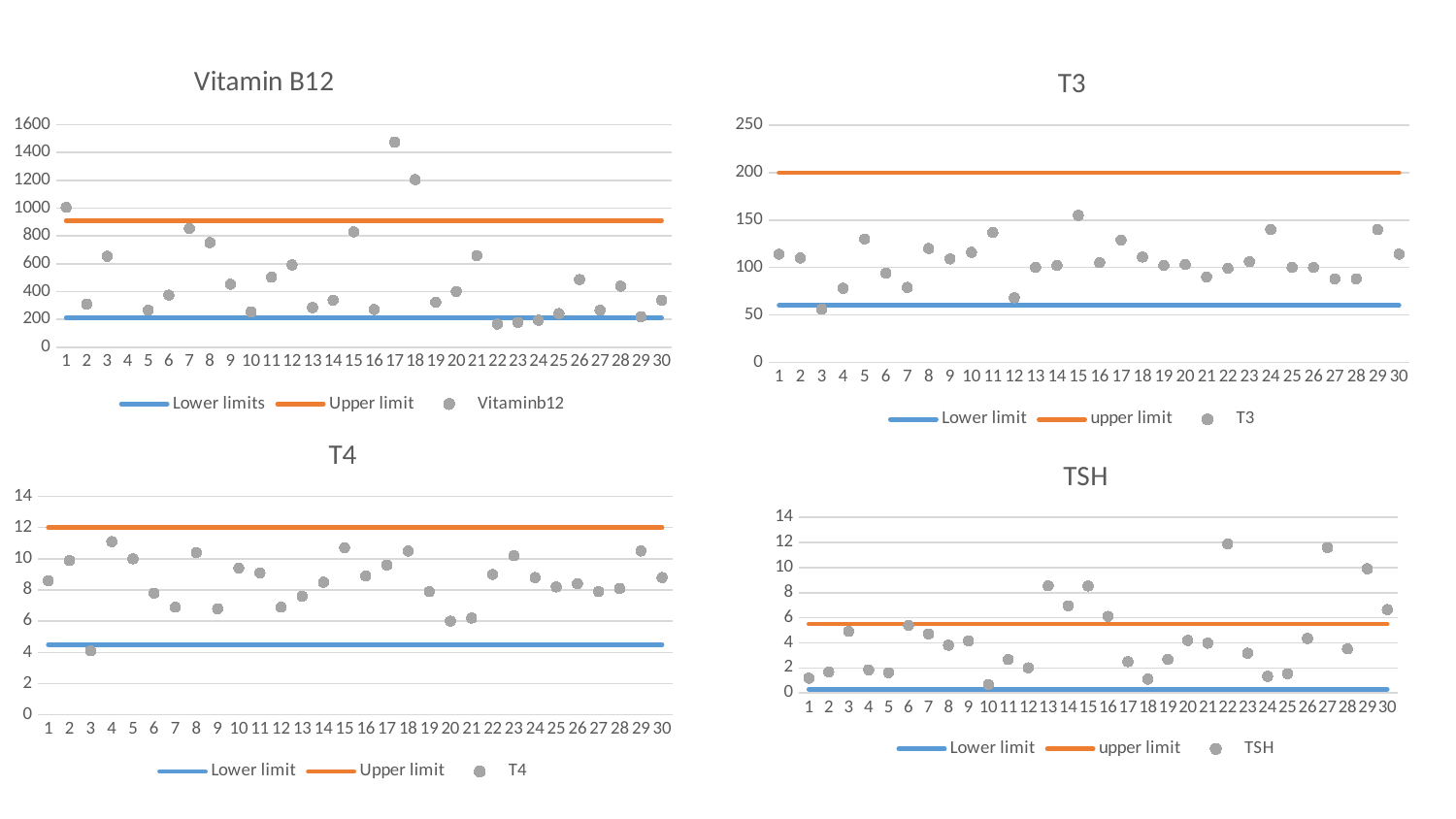
In the T4 chart, which point number has the lowest T4 value? 3 In the T3 chart, what value does the upper limit line sit at? 200 In the T3 chart, is the T3 value for point 3 greater or less than 100? less In the Vitamin B12 chart, which point number has the highest Vitaminb12 value? 17 In the T4 chart, what value does the Upper limit line sit at? 12 In the TSH chart, is the TSH value for point 22 greater or less than 10? greater In the Vitamin B12 chart, how many data points are plotted for the Vitaminb12 series? 29 In the T3 chart, how many series does the legend list? 3 In the Vitamin B12 chart, is the Vitaminb12 value for point 18 greater or less than 1000? greater What kind of chart is the TSH chart? line chart In the T3 chart, which point number has the highest T3 value? 15